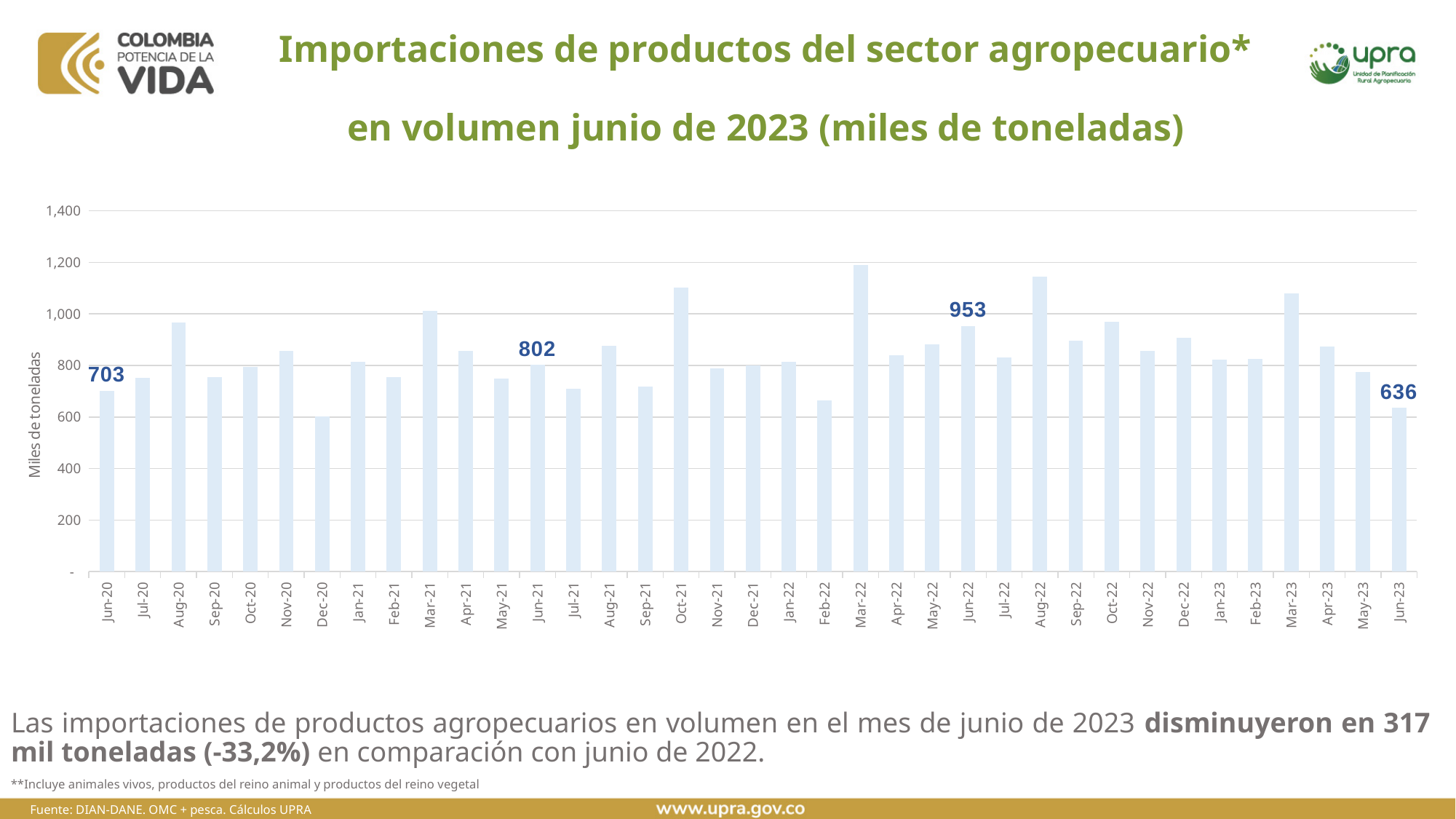
What is the difference between the values for Jun-21 and Jun-20? 99 Which is larger, the value for Jun-22 or the value for Jun-23? Jun-22 What is the value for Jun-22? 953 What is the value for Jun-20? 703 Is the value for Feb-22 greater or less than 800? less Is the value for Mar-22 greater or less than 1,000? greater Which month has the highest bar in the chart? Mar-22 What is the difference between the values for Jun-22 and Jun-23? 317 What is the value for Jun-21? 802 What is the value for Jun-23? 636 What kind of chart is shown on the slide? Bar chart How many monthly bars are plotted in the chart? 37